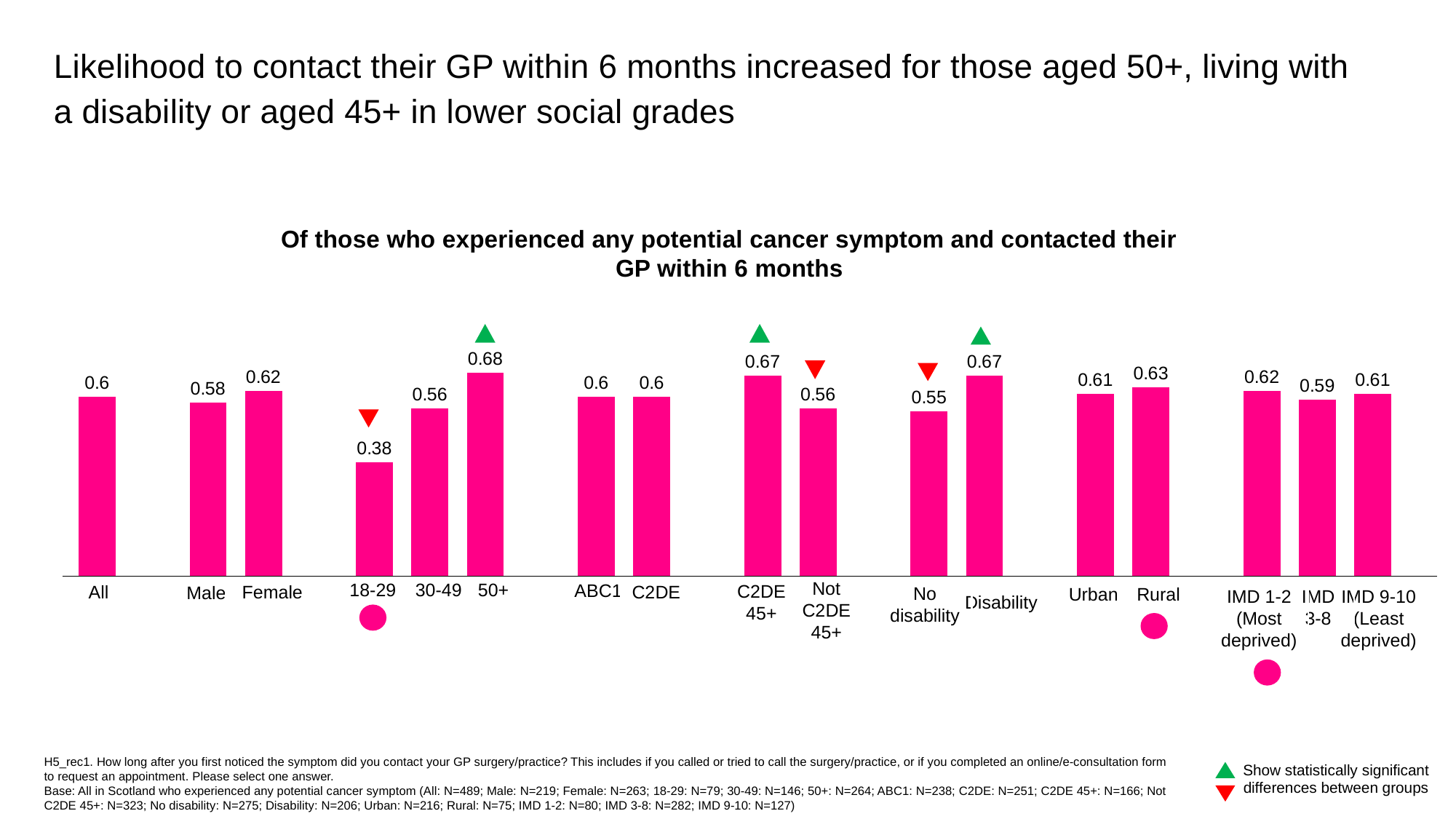
Which category has the highest value? 50+ What kind of chart is shown on the slide? Bar chart What is the difference between the values for Disability and No disability? 0.12 What is the value for Rural? 0.63 What is the value for the 18-29 age group? 0.38 What is the value for No disability? 0.55 What is the difference between the values for 50+ and 18-29? 0.3 How many bars are plotted in the chart? 17 Which is larger, the value for Female or the value for Male? Female Which category has the lowest value? 18-29 What is the value for the 50+ age group? 0.68 Which is larger, the value for C2DE 45+ or the value for Not C2DE 45+? C2DE 45+